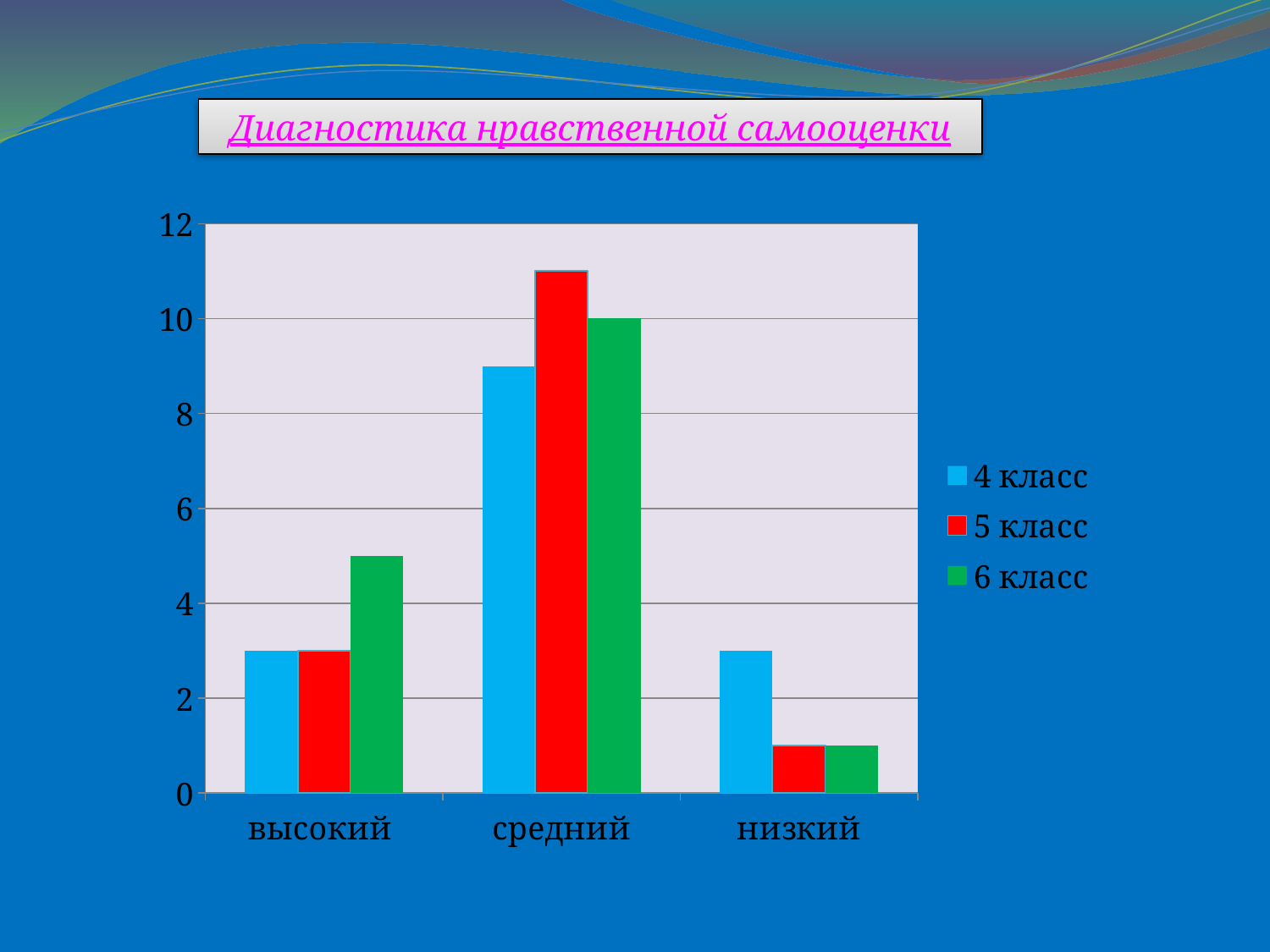
Is the value for 5 класс in the низкий category greater or less than 2? less In the средний category, which is larger: the value for 5 класс or the value for 4 класс? 5 класс What is the title of the chart? Диагностика нравственной самооценки Which category has the lowest value for 6 класс? низкий Which category has the highest value for 5 класс? средний Is the value for 4 класс in the средний category greater or less than 8? greater How many categories are shown on the x axis? 3 Is the value for 5 класс in the средний category greater or less than 10? greater How many series does the legend list? 3 What is the value for 6 класс in the средний category? 10 What kind of chart is shown on the slide? bar chart